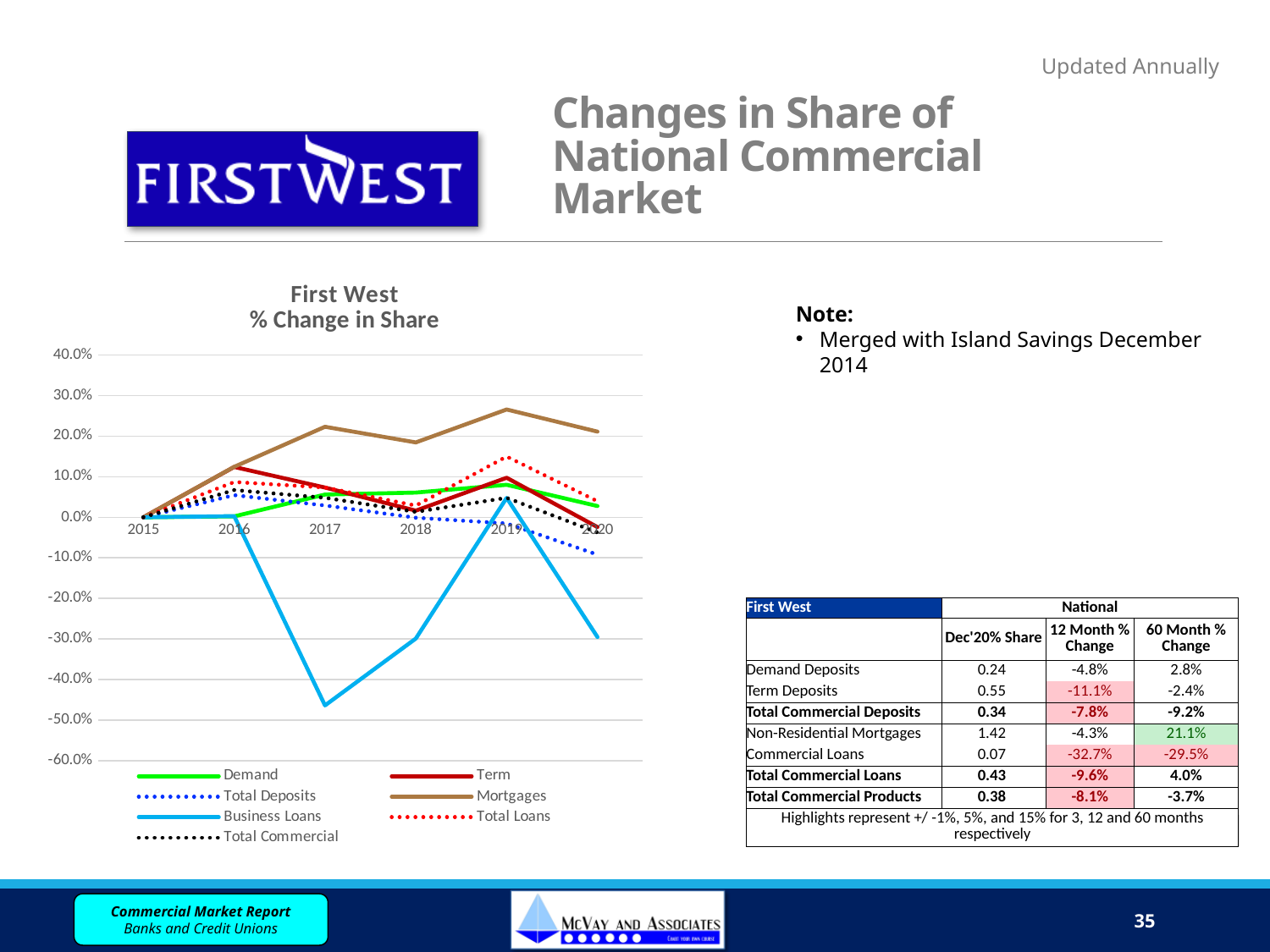
Is the value for Total Deposits in 2020 greater or less than 0.0%? less Is the value for Mortgages in 2020 greater or less than 10.0%? greater What is the title of the chart? First West % Change in Share In 2017, which is larger: the value for Mortgages or the value for Business Loans? Mortgages What kind of chart is shown on the slide? line chart Which series has the highest value in 2019? Mortgages Which series has the lowest value in 2017? Business Loans Is the value for Mortgages in 2019 greater or less than 20.0%? greater How many years are shown along the x axis of the chart? 6 How many series does the legend of the chart list? 7 Does the Mortgages series rise or fall from 2015 to 2017? rise